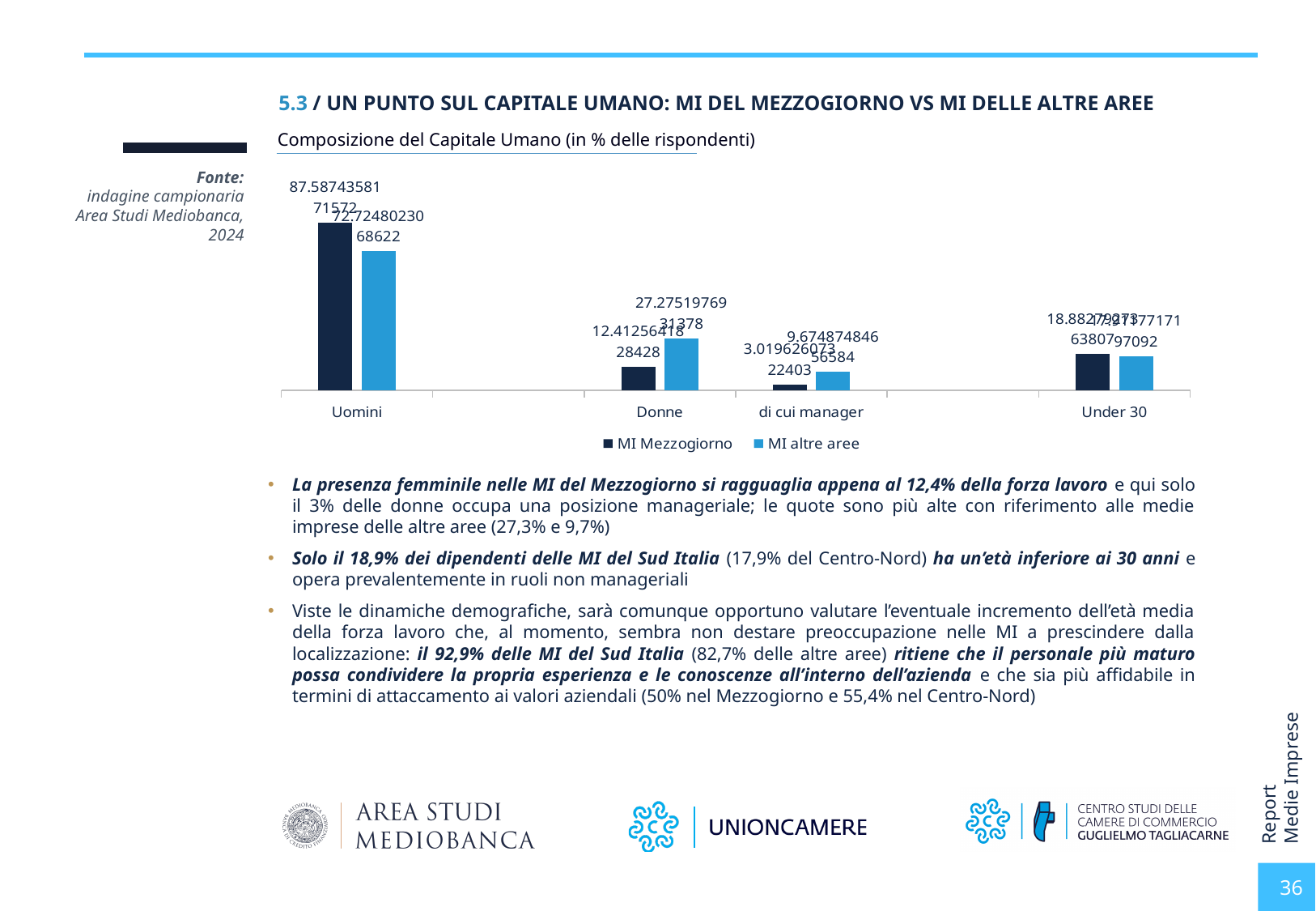
How many categories are shown on the x axis of the chart? 4 What is the value for MI Mezzogiorno in the Uomini category? 87.5874358171572 In the Donne category, which series has the larger value, MI Mezzogiorno or MI altre aree? MI altre aree Which category has the lowest value for MI altre aree? di cui manager Which category has the highest value for MI Mezzogiorno? Uomini Which series is shown in dark navy in the chart? MI Mezzogiorno What is the value for MI altre aree in the 'di cui manager' category? 9.67487484656584 What kind of chart is shown on the slide? Bar chart What is the title of the chart? Composizione del Capitale Umano (in % delle rispondenti) What is the value for MI altre aree in the Uomini category? 72.7248023068622 How many series does the chart legend list? 2 What is the value for MI Mezzogiorno in the 'di cui manager' category? 3.01962607322403